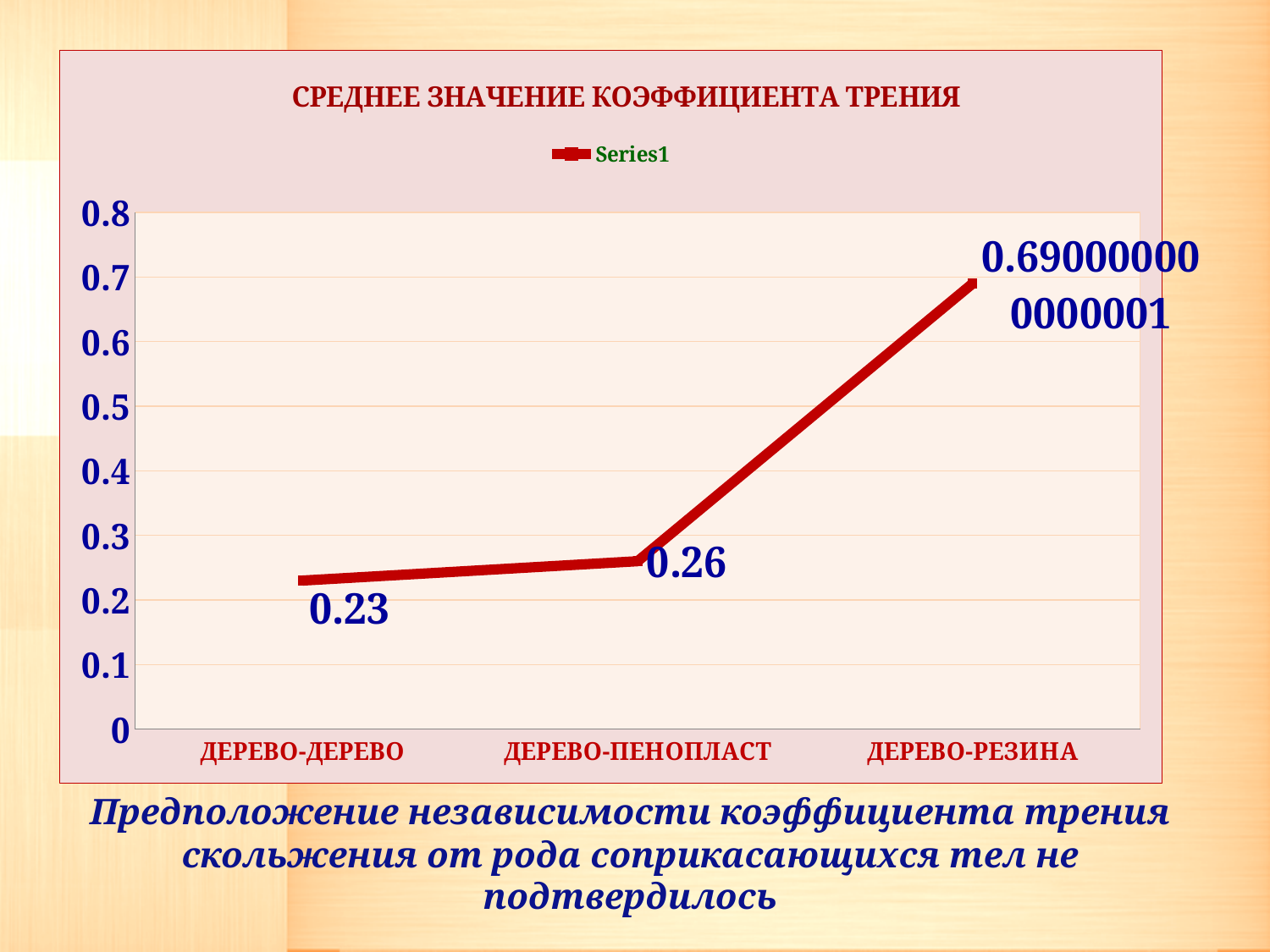
What is the title of the chart? СРЕДНЕЕ ЗНАЧЕНИЕ КОЭФФИЦИЕНТА ТРЕНИЯ What is the difference between the values for ДЕРЕВО-ПЕНОПЛАСТ and ДЕРЕВО-ДЕРЕВО? 0.03 Which is larger, the value for ДЕРЕВО-РЕЗИНА or the value for ДЕРЕВО-ПЕНОПЛАСТ? ДЕРЕВО-РЕЗИНА What type of chart is shown on the slide? line chart Which category has the lowest value? ДЕРЕВО-ДЕРЕВО Do the values rise or fall from left to right along the x axis? rise How many series does the legend list? 1 What is the value for ДЕРЕВО-ПЕНОПЛАСТ? 0.26 What is the value for ДЕРЕВО-РЕЗИНА? 0.690000000000001 How many categories are plotted on the x axis? 3 Which category has the highest value? ДЕРЕВО-РЕЗИНА What is the value for ДЕРЕВО-ДЕРЕВО? 0.23